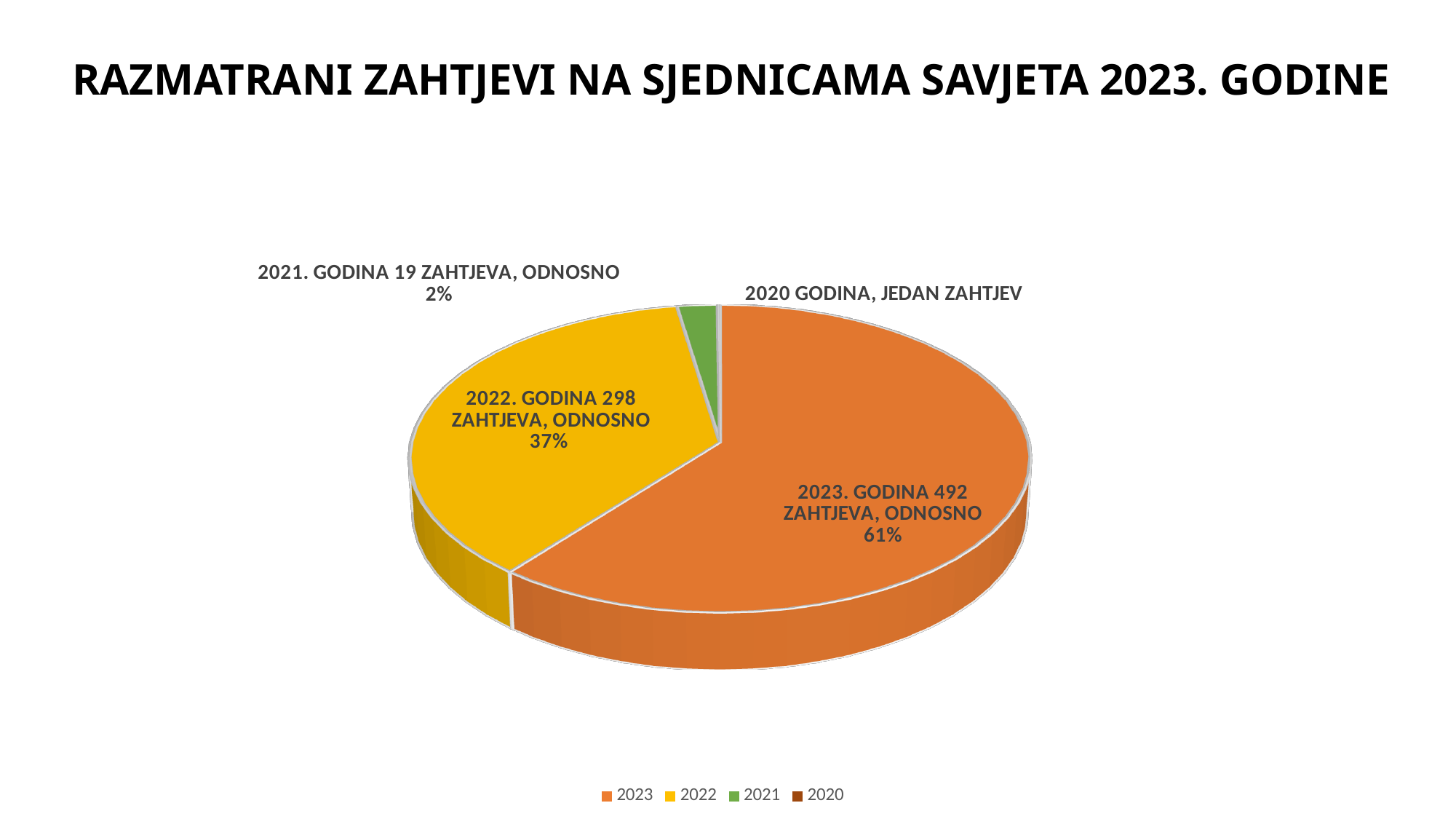
Which year has the largest slice of the pie? 2023 What is the title of the chart? RAZMATRANI ZAHTJEVI NA SJEDNICAMA SAVJETA 2023. GODINE Which year has the smallest slice of the pie? 2020 What share of the pie does 2022 represent? 37% What share of the pie does 2023 represent? 61% What is the difference between the number of requests in 2023 and in 2022? 194 What share of the pie does 2021 represent? 2% How many requests (zahtjeva) were considered for 2021? 19 How many requests (zahtjeva) were considered for 2023? 492 What kind of chart is shown on the slide? pie chart How many entries does the legend list? 4 How many requests (zahtjeva) were considered for 2022? 298